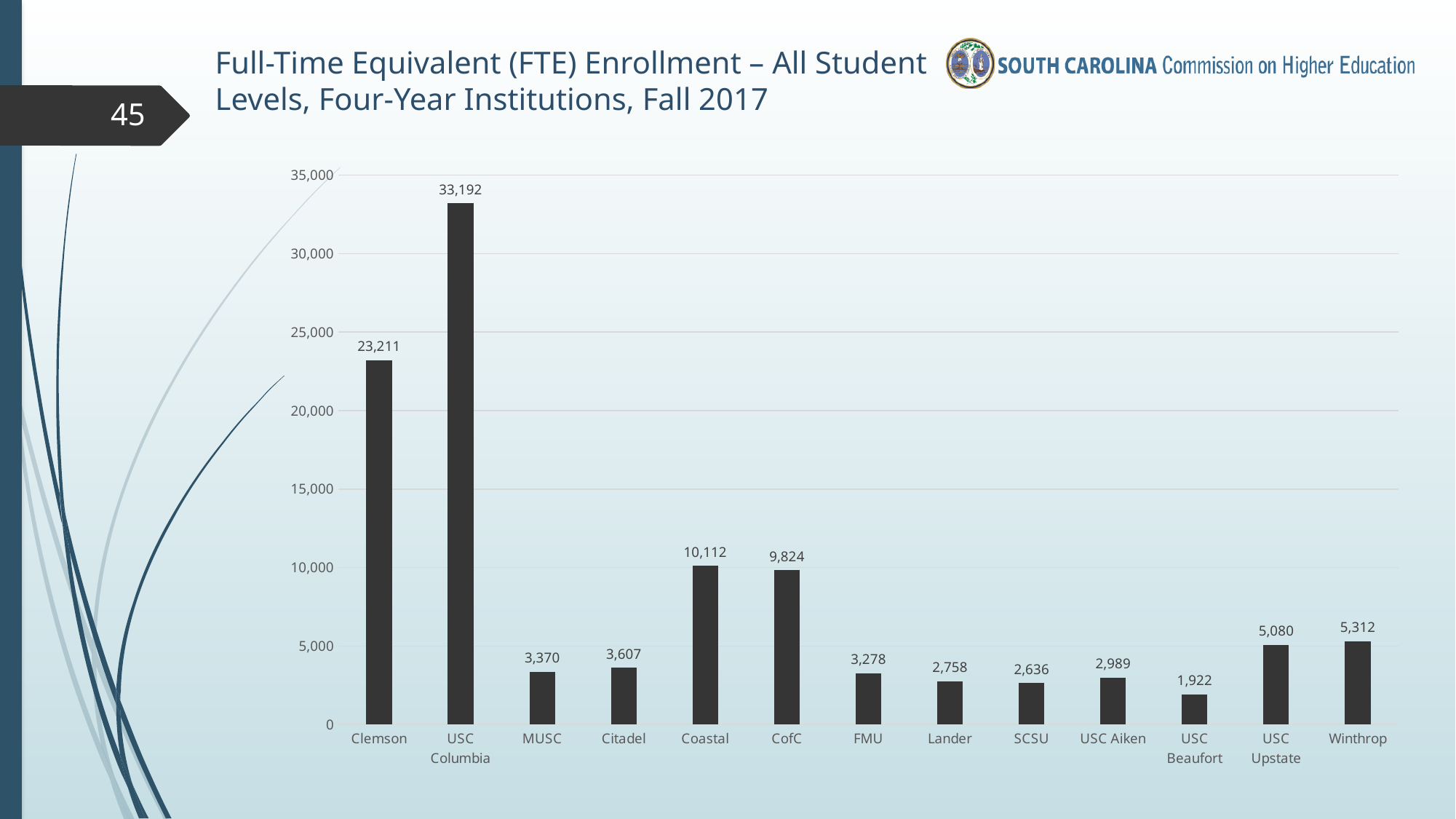
What is the difference in FTE enrollment between Coastal and CofC? 288 What is the FTE enrollment for Coastal? 10,112 Which institution has the highest FTE enrollment? USC Columbia What is the difference in FTE enrollment between USC Columbia and Clemson? 9,981 What is the FTE enrollment for USC Beaufort? 1,922 How many institutions are shown on the chart? 13 What is the FTE enrollment for USC Columbia? 33,192 Which institution has the lowest FTE enrollment? USC Beaufort Which has a larger FTE enrollment, Winthrop or USC Upstate? Winthrop What kind of chart is shown on the slide? Bar chart Which has a larger FTE enrollment, Citadel or MUSC? Citadel What is the title of the chart on the slide? Full-Time Equivalent (FTE) Enrollment – All Student Levels, Four-Year Institutions, Fall 2017